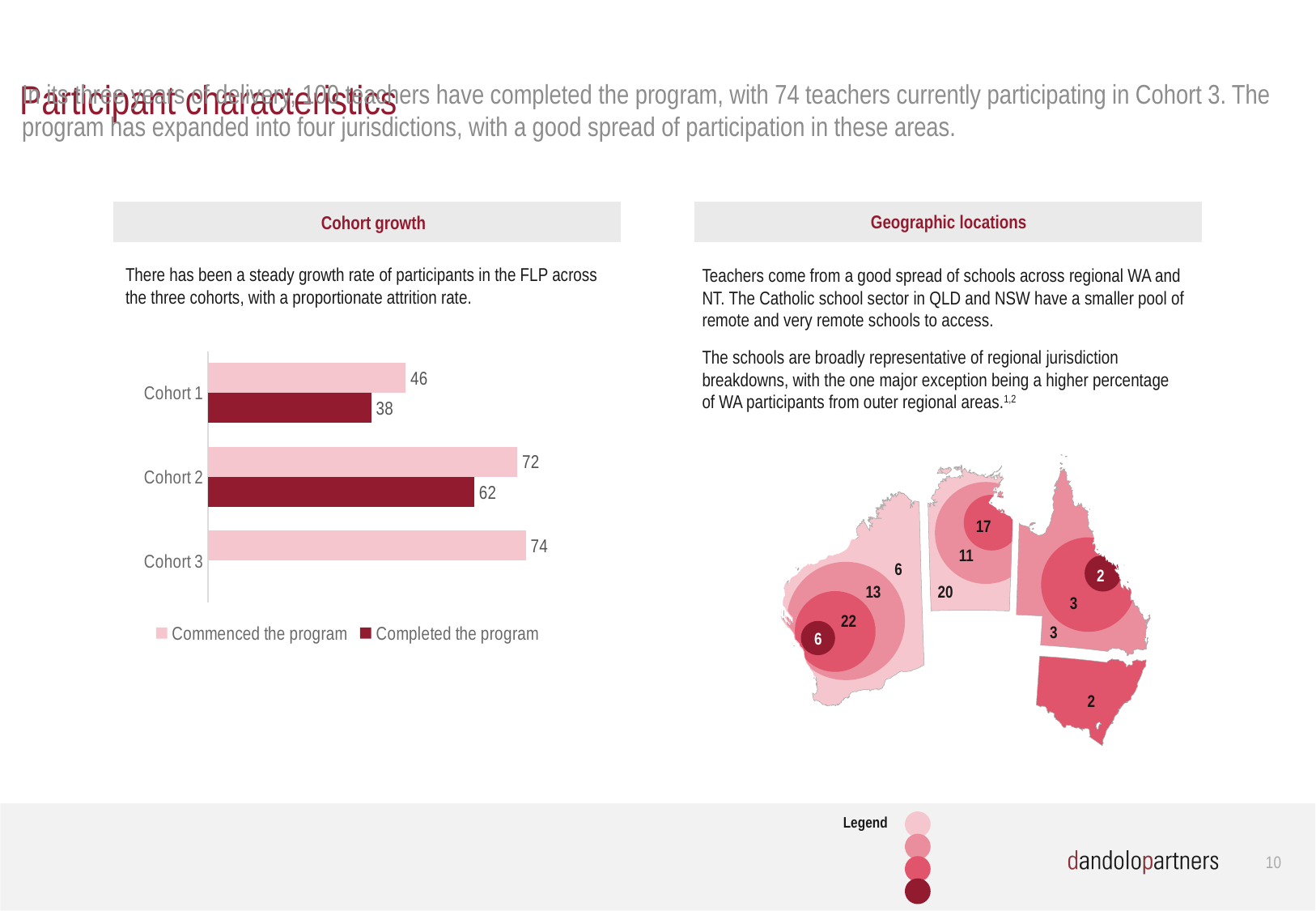
In the Cohort growth chart, how many participants completed the program in Cohort 2? 62 In the Cohort growth chart, how many participants commenced the program in Cohort 3? 74 In the Cohort growth chart, which is larger: the number who completed the program in Cohort 1 or in Cohort 2? Cohort 2 In the Cohort growth chart, how many participants commenced the program in Cohort 1? 46 In the Cohort growth chart, what is the difference between the number who commenced the program in Cohort 2 and in Cohort 1? 26 In the Cohort growth chart, which cohort has the lowest number of participants who completed the program? Cohort 1 How many cohorts are shown in the Cohort growth chart? 3 In the Cohort growth chart, does the number of participants who commenced the program rise or fall from Cohort 1 to Cohort 3? Rise What type of chart is the Cohort growth chart? Bar chart How many series does the legend of the Cohort growth chart list? 2 In the Cohort growth chart, which cohort has the highest number of participants who commenced the program? Cohort 3 In the Cohort growth chart, what is the difference between the number who commenced and the number who completed the program in Cohort 2? 10